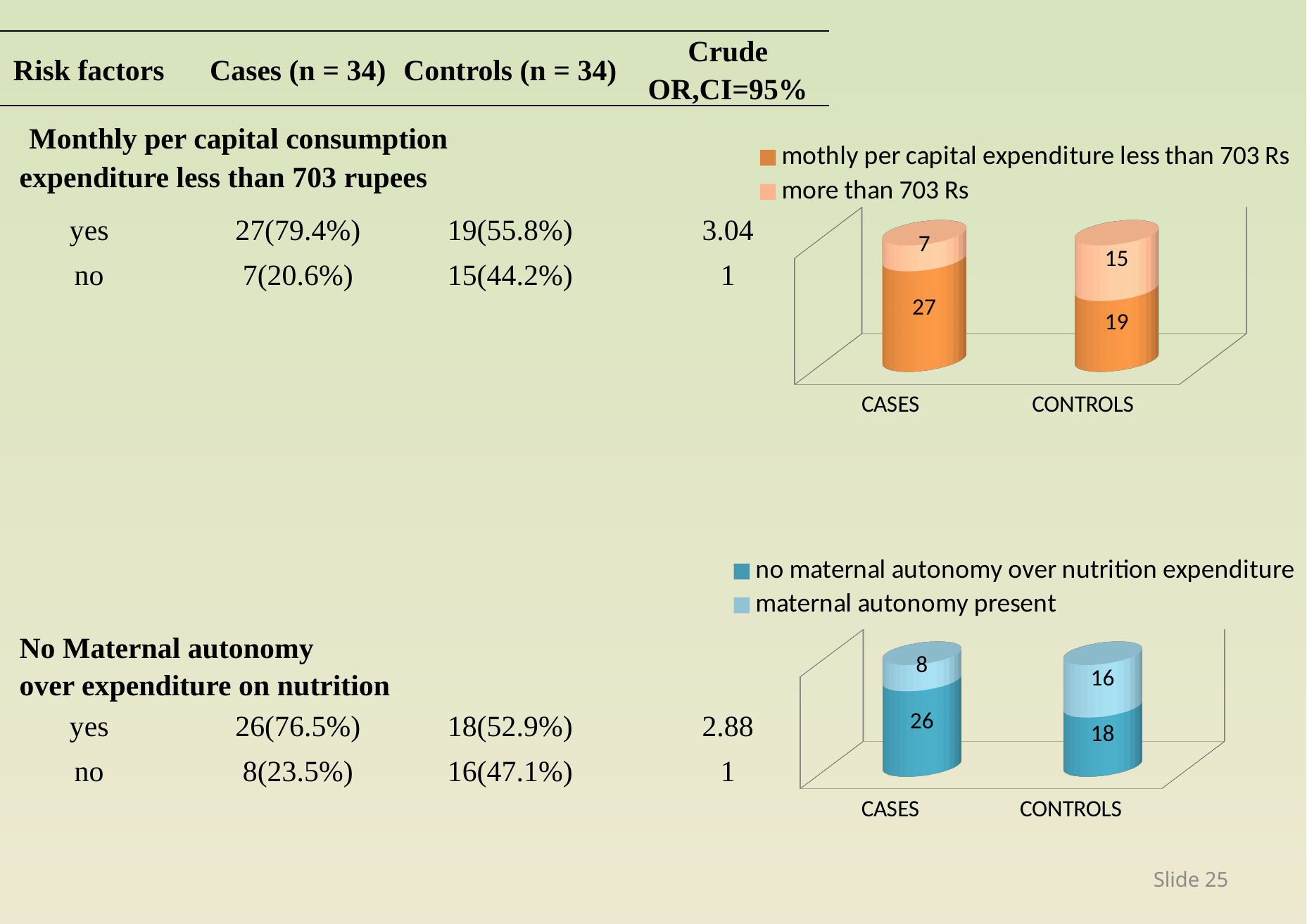
In the top chart, what is the difference between the 'mothly per capital expenditure less than 703 Rs' values for CASES and CONTROLS? 8 In the bottom chart, how many categories are shown on the x axis? 2 In the top chart, what is the value for 'mothly per capital expenditure less than 703 Rs' for CASES? 27 In the bottom chart, what is the total of the stacked bar for CONTROLS? 34 In the bottom chart, what is the value for 'maternal autonomy present' for CONTROLS? 16 In the top chart, which category has the higher value for 'more than 703 Rs', CASES or CONTROLS? CONTROLS In the top chart, what is the value for 'more than 703 Rs' for CONTROLS? 15 In the bottom chart, what is the value for 'no maternal autonomy over nutrition expenditure' for CASES? 26 What kind of chart is the bottom chart? Stacked bar chart In the top chart, how many series does the legend list? 2 In the top chart, what is the total of the stacked bar for CASES? 34 In the bottom chart, what is the difference between the 'maternal autonomy present' values for CONTROLS and CASES? 8